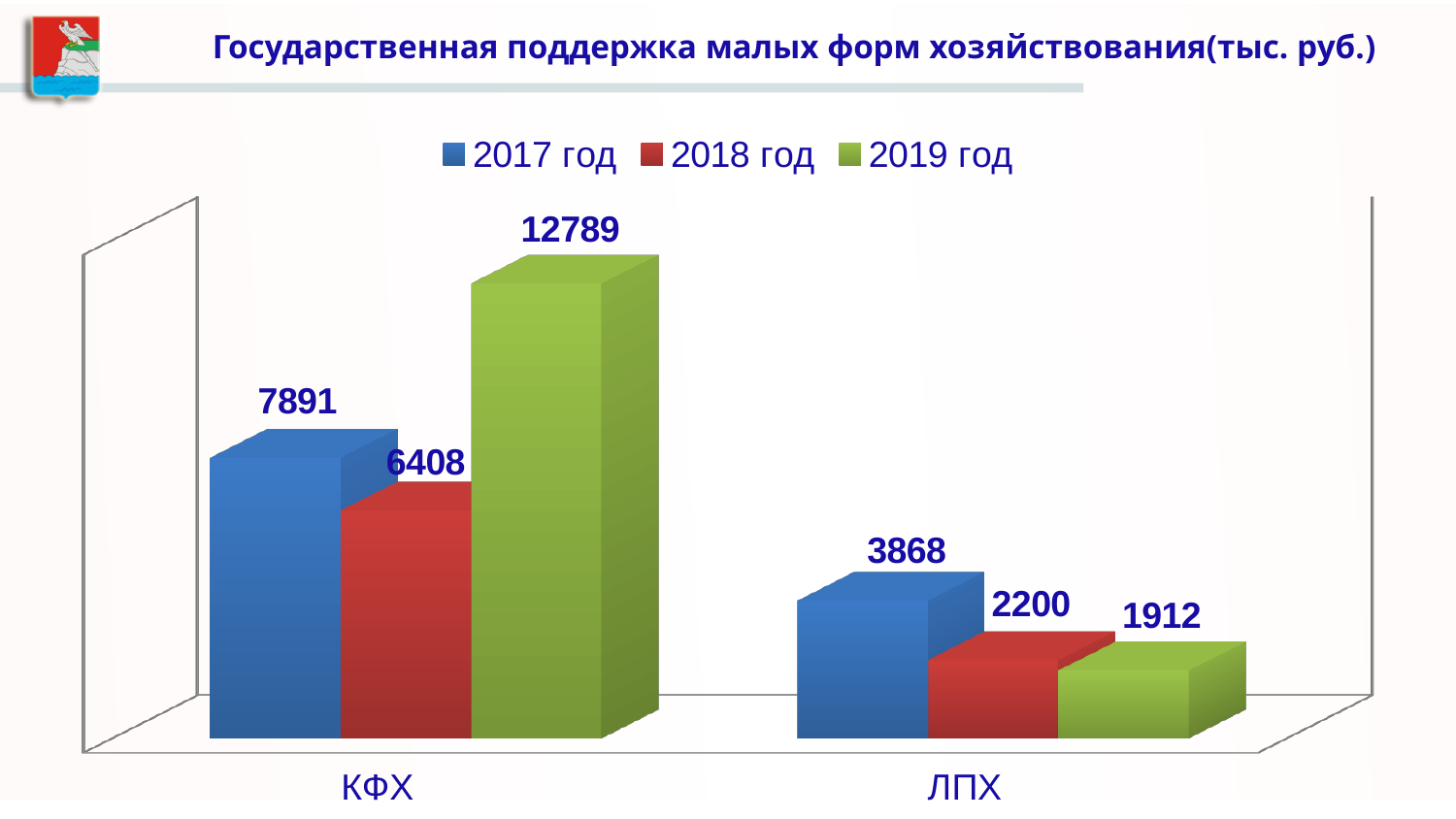
Which is larger: the 2018 год value for КФХ or the 2017 год value for ЛПХ? 2018 год value for КФХ What is the difference between the 2019 год and 2017 год values for КФХ? 4898 What is the value for КФХ in 2018 год? 6408 Which year has the lowest value for ЛПХ? 2019 год What is the value for ЛПХ in 2019 год? 1912 What is the difference between the 2017 год and 2018 год values for ЛПХ? 1668 Which year has the highest value for КФХ? 2019 год How many categories are shown on the x axis? 2 What kind of chart is shown on the slide? Bar chart What is the value for КФХ in 2017 год? 7891 What is the title of the chart? Государственная поддержка малых форм хозяйствования(тыс. руб.) How many series does the legend list? 3